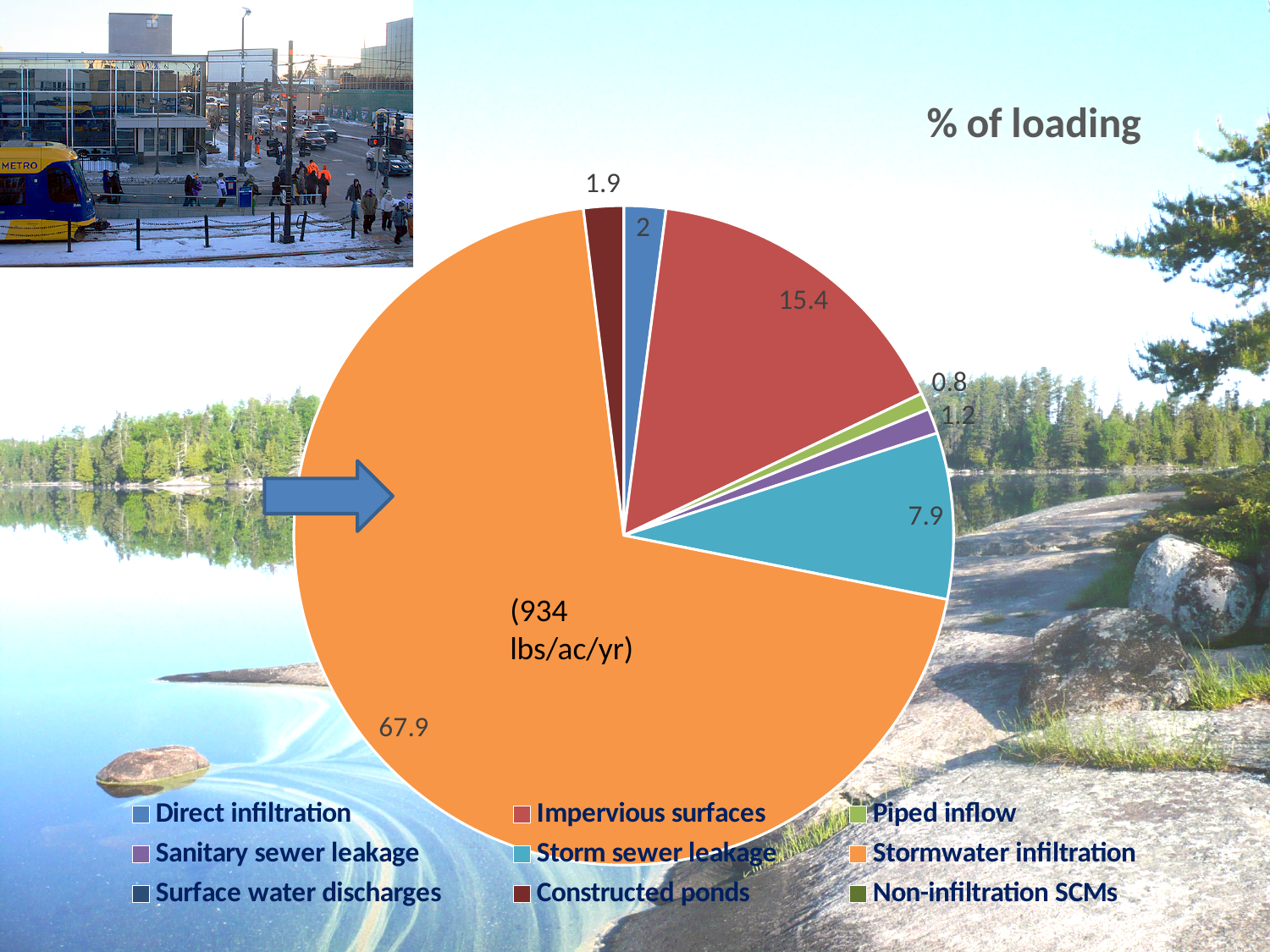
What percentage of loading is attributed to Stormwater infiltration? 67.9 How many categories does the legend list? 9 Which category accounts for the largest share of loading? Stormwater infiltration Which is larger, the share for Piped inflow or the share for Sanitary sewer leakage? Sanitary sewer leakage What percentage of loading is attributed to Impervious surfaces? 15.4 What is the title of the chart? % of loading What is the difference between the Impervious surfaces share and the Storm sewer leakage share? 7.5 What percentage of loading is attributed to Constructed ponds? 1.9 What percentage of loading is attributed to Sanitary sewer leakage? 1.2 What percentage of loading is attributed to Direct infiltration? 2 What percentage of loading is attributed to Storm sewer leakage? 7.9 What type of chart is shown on the slide? pie chart